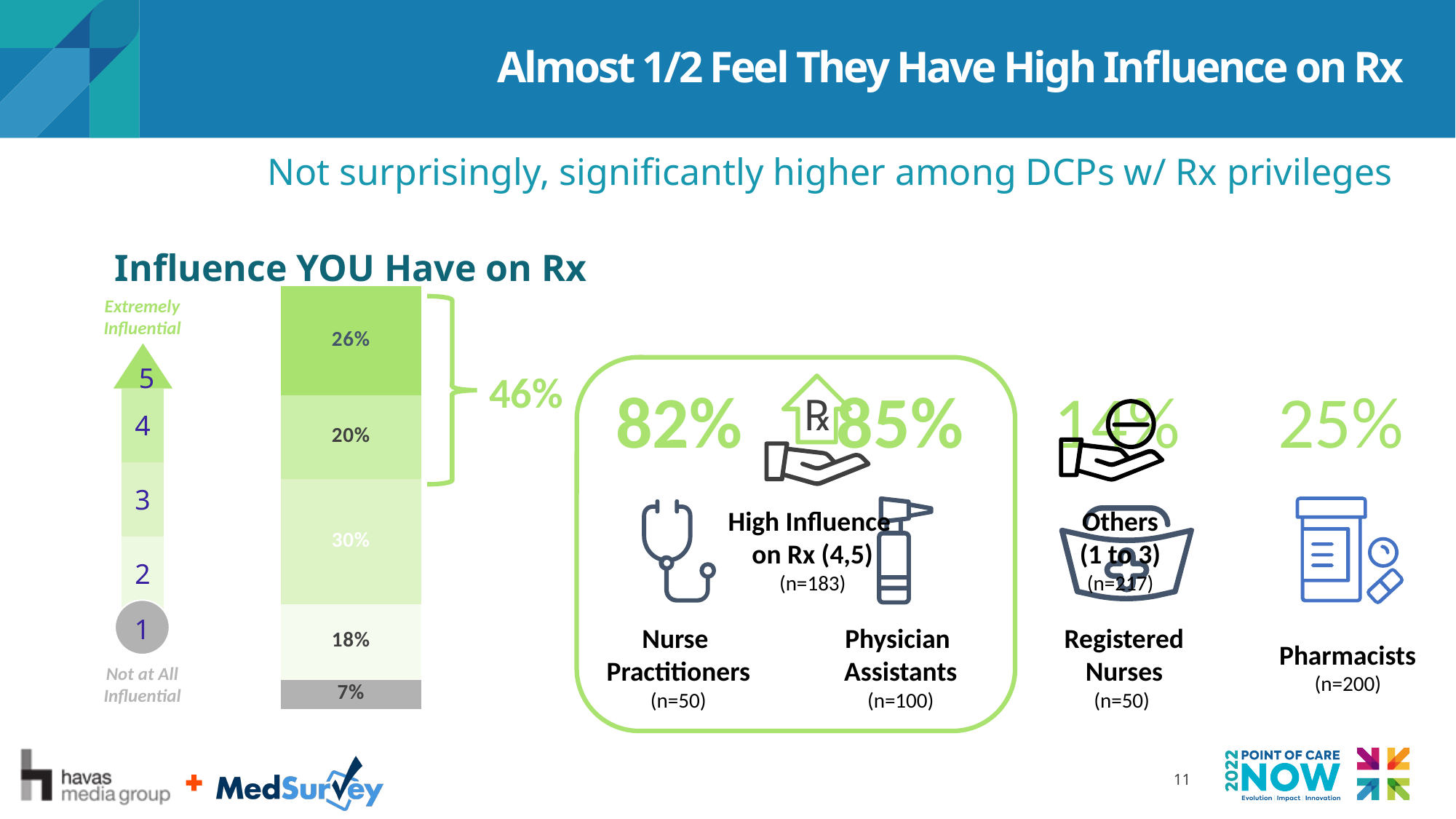
How many segments make up the stacked bar in the 'Influence YOU Have on Rx' chart? 5 In the 'Influence YOU Have on Rx' chart, which is larger: the share rating 2 or the share rating 4? 4 In the 'Influence YOU Have on Rx' chart, what percentage of respondents gave a rating of 2? 18% In the 'Influence YOU Have on Rx' chart, what combined percentage is shown by the bracket for ratings 4 and 5? 46% In the 'Influence YOU Have on Rx' chart, what percentage of respondents gave a rating of 3? 30% In the 'Influence YOU Have on Rx' chart, which rating level has the smallest share of respondents? 1 In the 'Influence YOU Have on Rx' chart, what percentage of respondents rated their influence as 1 (Not at All Influential)? 7% In the 'Influence YOU Have on Rx' chart, what percentage of respondents rated their influence as 5 (Extremely Influential)? 26% In the 'Influence YOU Have on Rx' chart, what is the difference between the share rating 5 and the share rating 4? 6% What percentage of Physician Assistants (n=100) report high influence on Rx (4,5)? 85% In the 'Influence YOU Have on Rx' chart, which rating level has the largest share of respondents? 3 What type of chart is 'Influence YOU Have on Rx'? Stacked bar chart